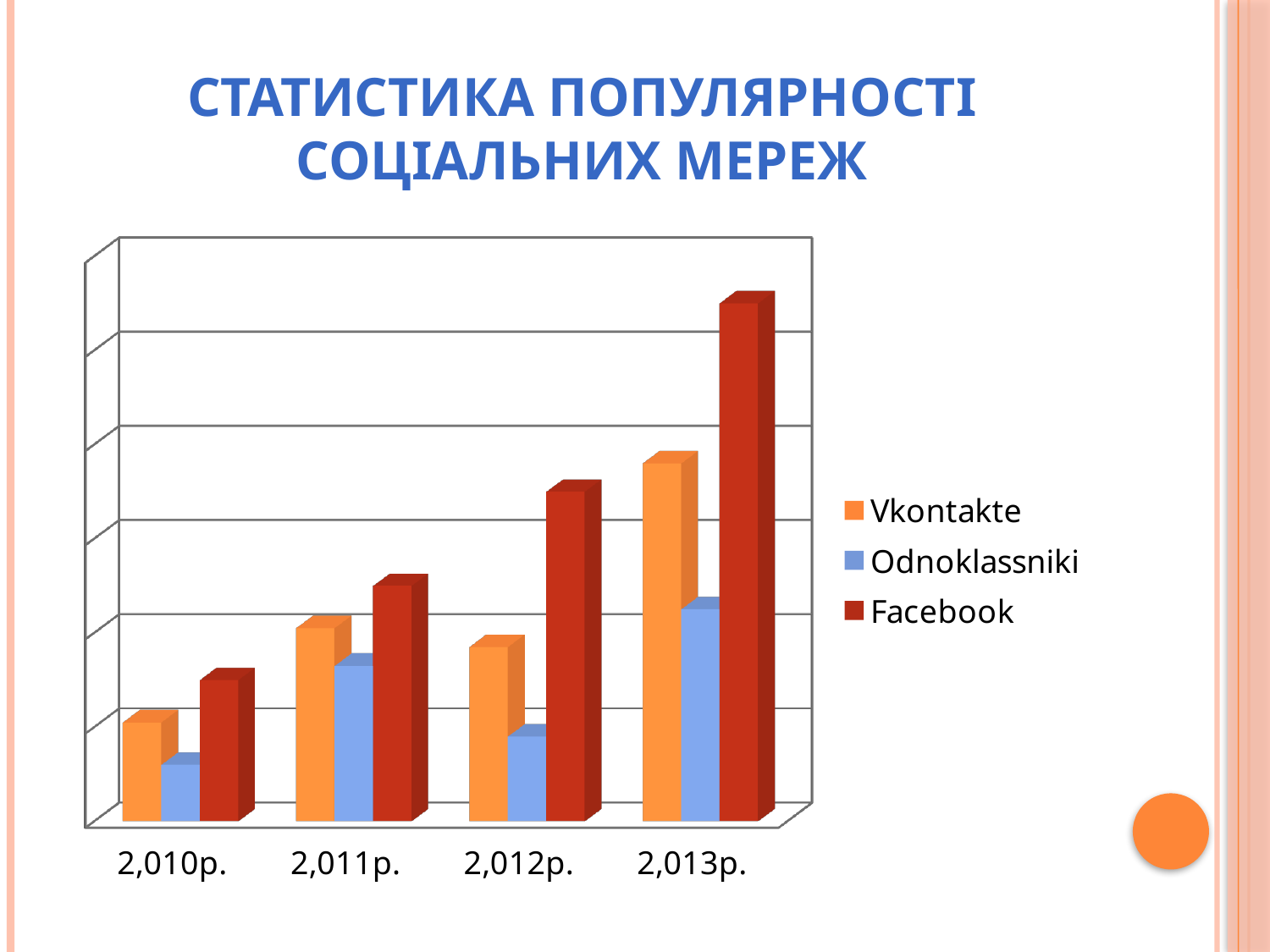
How many year categories are shown on the x axis? 4 Do the Facebook values rise or fall from 2,010р. to 2,013р.? rise In 2,012р., which is larger: Facebook or Vkontakte? Facebook Which series is shown in red in the legend? Facebook In which year is the Facebook bar the highest? 2,013р. Which series is shown in blue in the legend? Odnoklassniki In which year is the Vkontakte bar the highest? 2,013р. In which year is the Facebook bar the lowest? 2,010р. How many series does the legend list? 3 Which series has the shortest bar in 2,010р.? Odnoklassniki What kind of chart is shown on the slide? bar chart Which series has the tallest bar in 2,013р.? Facebook